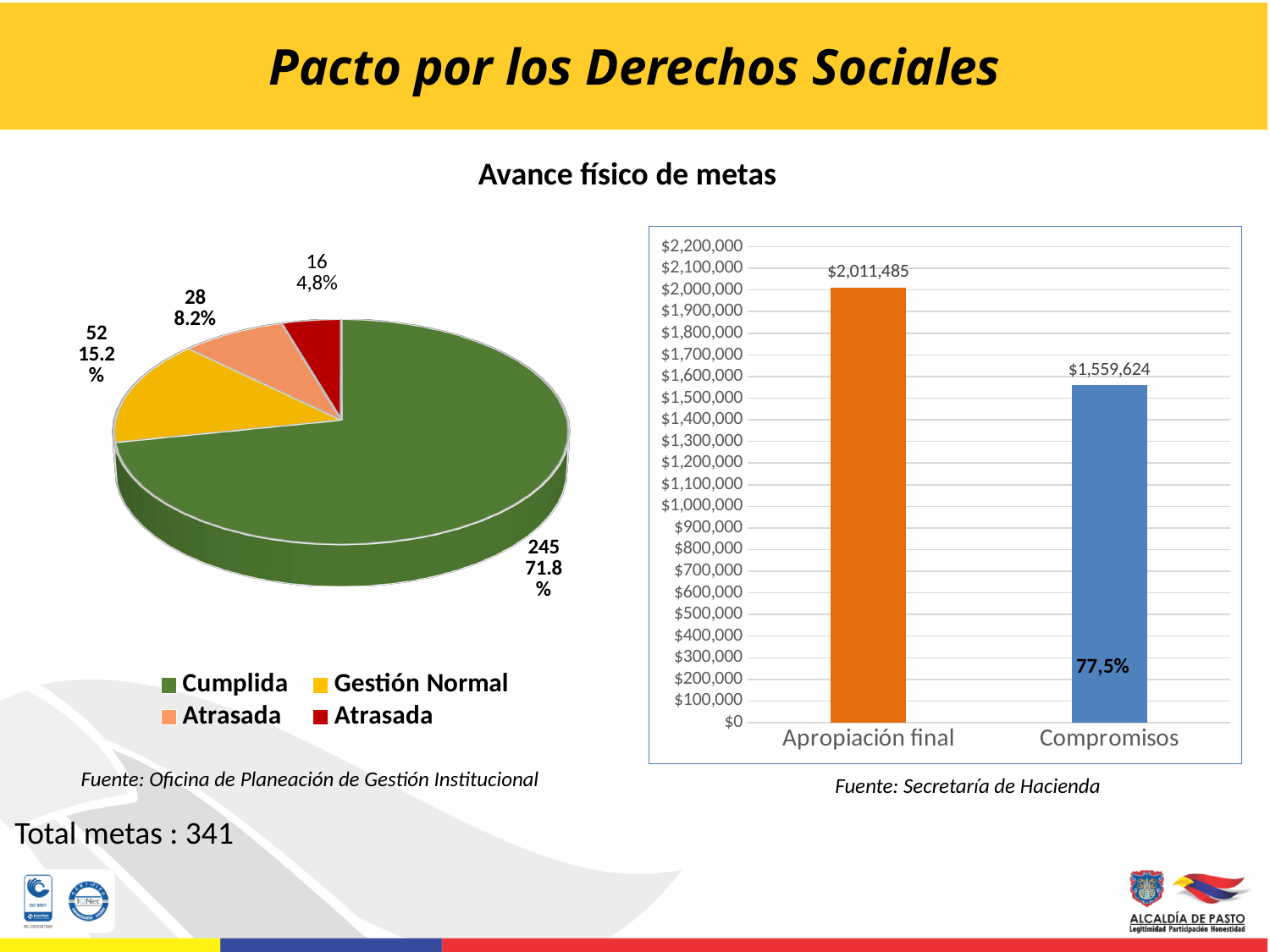
In the pie chart on the left, how many slices does the pie have? 4 In the bar chart on the right, what is the difference between Apropiación final and Compromisos? $451,861 In the bar chart on the right, which is larger, Apropiación final or Compromisos? Apropiación final In the bar chart on the right, what is the value for Apropiación final? $2,011,485 In the pie chart on the left, which category has the largest slice? Cumplida In the pie chart on the left, what is the value for Gestión Normal? 52 In the pie chart on the left, how many entries does the legend list? 4 What kind of chart is shown on the right side of the slide? Bar chart In the pie chart on the left, what share of the pie does Gestión Normal represent? 15.2% In the bar chart on the right, what is the value for Compromisos? $1,559,624 In the pie chart on the left, what is the value for Cumplida? 245 In the pie chart on the left, what share of the pie does Cumplida represent? 71.8%